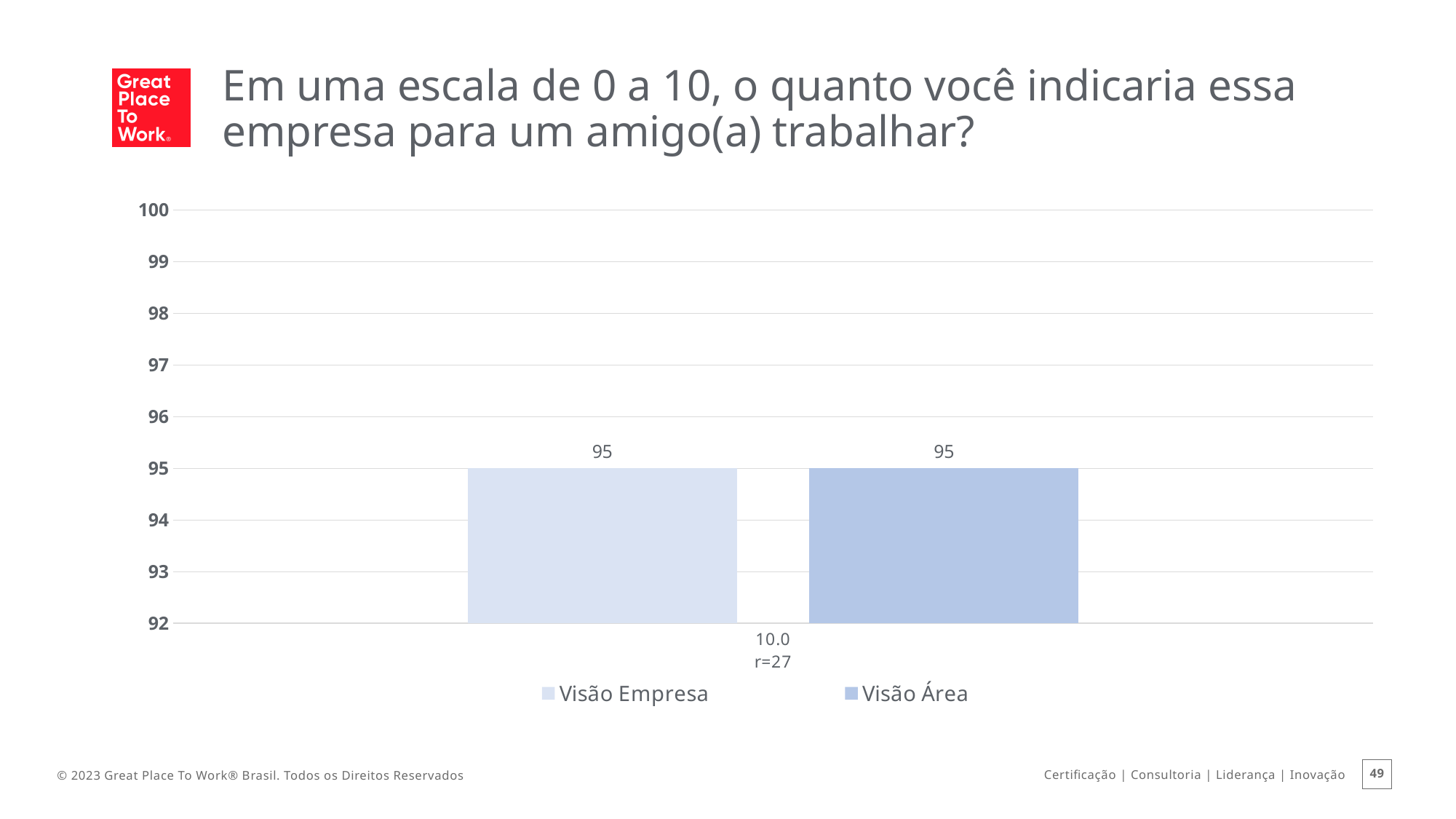
How many series does the legend list? 2 What is the label of the category on the x axis? 10.0 r=27 How many categories are shown on the x axis? 1 What kind of chart is shown on the slide? bar chart Is the value for Visão Empresa greater or less than 94? greater What is the value of the Visão Área bar? 95 What is the value of the Visão Empresa bar? 95 What is the highest value shown on the y axis? 100 What are the two series named in the legend? Visão Empresa and Visão Área What is the lowest value shown on the y axis? 92 What is the difference between the Visão Empresa and Visão Área values? 0 Is the value for Visão Área greater or less than 96? less